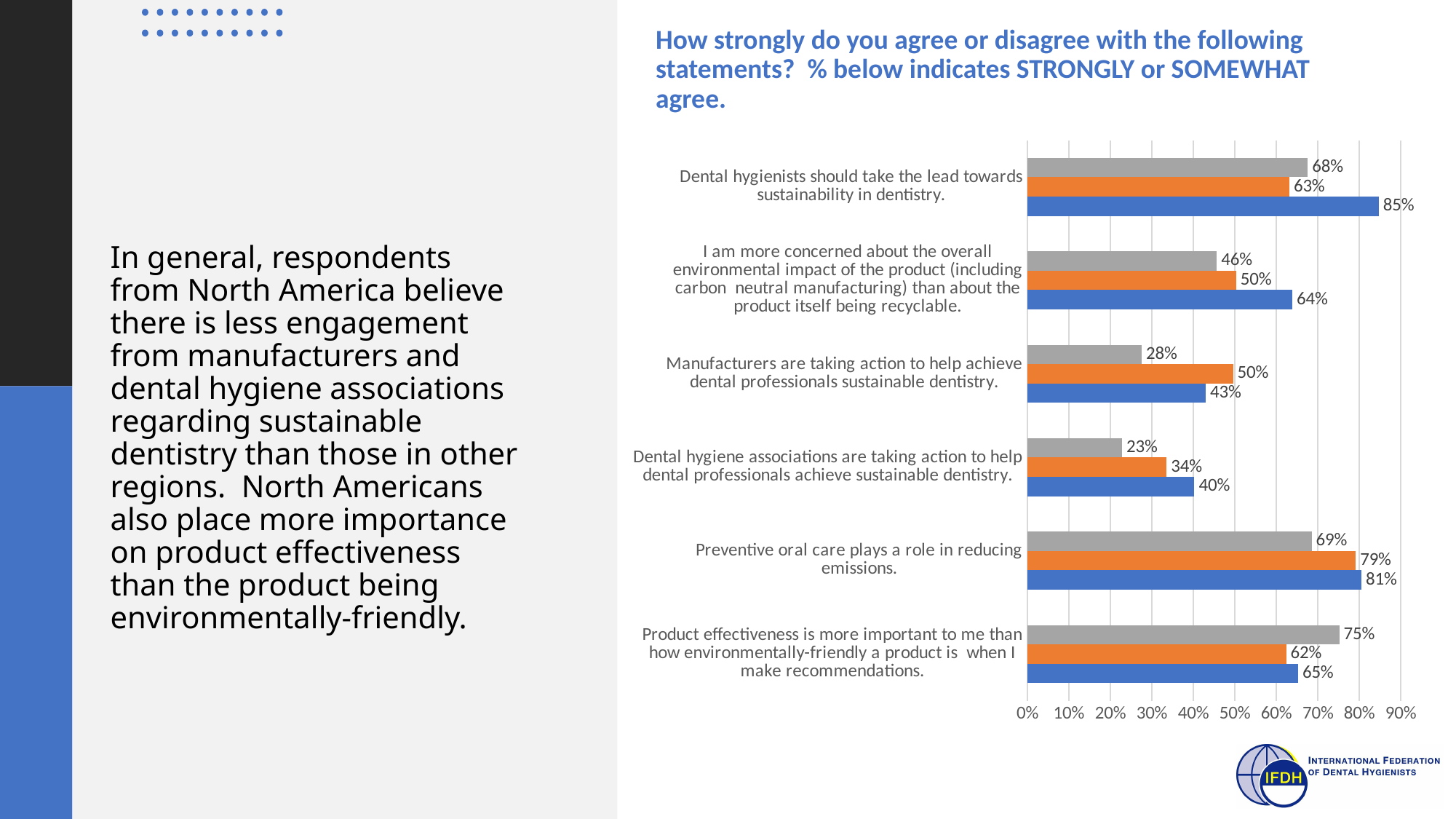
Which statement has the lowest gray bar value? Dental hygiene associations are taking action to help dental professionals achieve sustainable dentistry. What is the difference between the blue bar (85%) and the orange bar (63%) for 'Dental hygienists should take the lead towards sustainability in dentistry.'? 22% What is the maximum value shown on the horizontal axis of the chart? 90% For 'Manufacturers are taking action to help achieve dental professionals sustainable dentistry.', which is larger, the orange bar or the blue bar? orange bar What is the value of the orange bar for 'Preventive oral care plays a role in reducing emissions.'? 79% What is the value of the gray bar for 'Product effectiveness is more important to me than how environmentally-friendly a product is when I make recommendations.'? 75% How many statements (categories) are plotted in the chart? 6 What type of chart is shown on the slide? bar chart Which statement has the highest blue bar value? Dental hygienists should take the lead towards sustainability in dentistry. What is the value of the gray bar for 'Manufacturers are taking action to help achieve dental professionals sustainable dentistry.'? 28% What is the value of the blue bar for 'Dental hygienists should take the lead towards sustainability in dentistry.'? 85% For 'Dental hygiene associations are taking action to help dental professionals achieve sustainable dentistry.', what is the difference between the blue bar (40%) and the gray bar (23%)? 17%